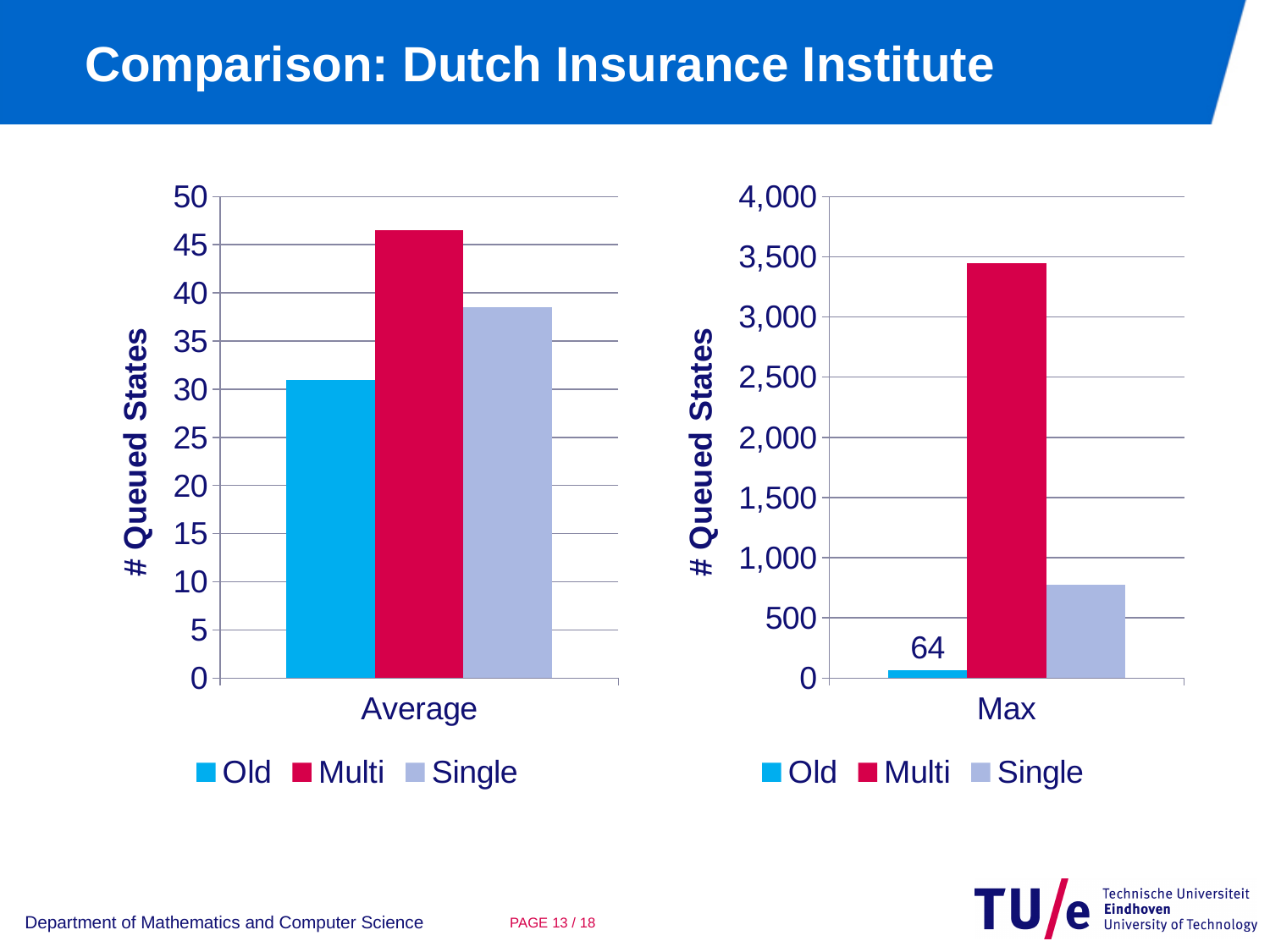
In the Average chart on the left, is the value for Old greater or less than 35? less How many series does the legend of the Max chart on the right list? 3 In the Max chart on the right, which series has the lowest value? Old In the Max chart on the right, is the value for Multi greater or less than 3,000? greater In the Average chart on the left, which series has the lowest value? Old In the Max chart on the right, is the value for Single greater or less than 1,000? less In the Max chart on the right, what is the value for Old? 64 In the Max chart on the right, which series has the highest value? Multi In the Average chart on the left, which series has the highest value? Multi What kind of chart is the Average chart on the left? Bar chart In the Average chart on the left, which is larger, the value for Single or the value for Old? Single